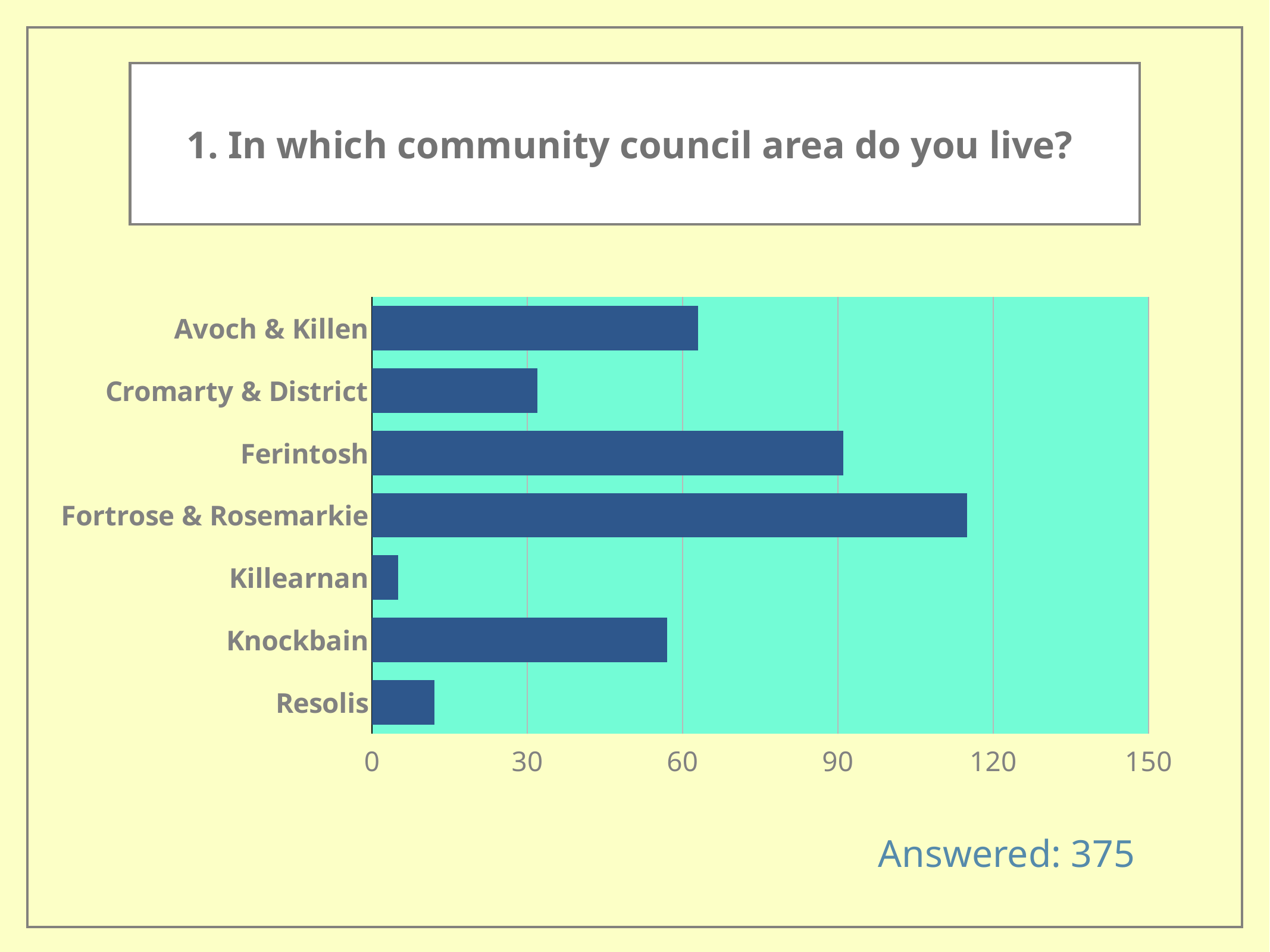
What kind of chart is shown on the slide? bar chart Which community council area has the highest value? Fortrose & Rosemarkie Is the value for Resolis greater or less than 30? less Is the value for Fortrose & Rosemarkie greater or less than 120? less Is the value for Avoch & Killen greater or less than 60? greater Which community council area has the lowest value? Killearnan How many respondents answered the question, according to the slide? 375 Which is larger, the value for Knockbain or the value for Cromarty & District? Knockbain Which is larger, the value for Ferintosh or the value for Avoch & Killen? Ferintosh How many community council areas are shown on the chart? 7